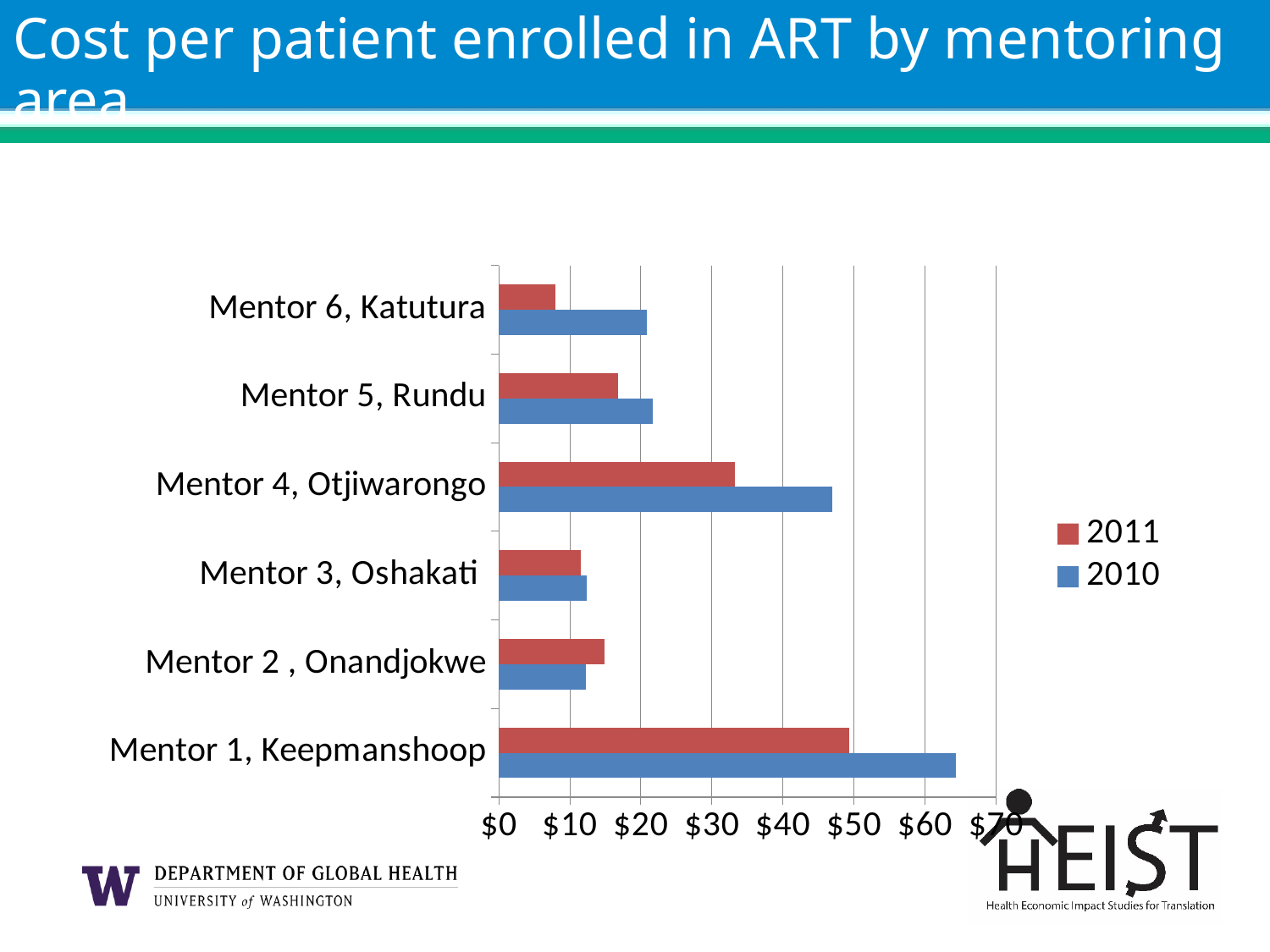
Which mentoring area has the highest cost per patient for 2011? Mentor 1, Keepmanshoop How many mentoring areas are shown on the chart? 6 Which mentoring area has the lowest cost per patient for 2011? Mentor 6, Katutura Which mentoring area has the highest cost per patient for 2010? Mentor 1, Keepmanshoop What kind of chart is shown on the slide? Bar chart Is the 2010 value for Mentor 4, Otjiwarongo greater or less than $40? greater Is the 2011 value for Mentor 6, Katutura greater or less than $10? less For Mentor 2, Onandjokwe, which year has the higher cost per patient, 2010 or 2011? 2011 How many series does the legend list? 2 Which colour represents the 2011 series in the legend? Red Is the 2010 value for Mentor 1, Keepmanshoop greater or less than $60? greater For Mentor 4, Otjiwarongo, which year has the higher cost per patient, 2010 or 2011? 2010